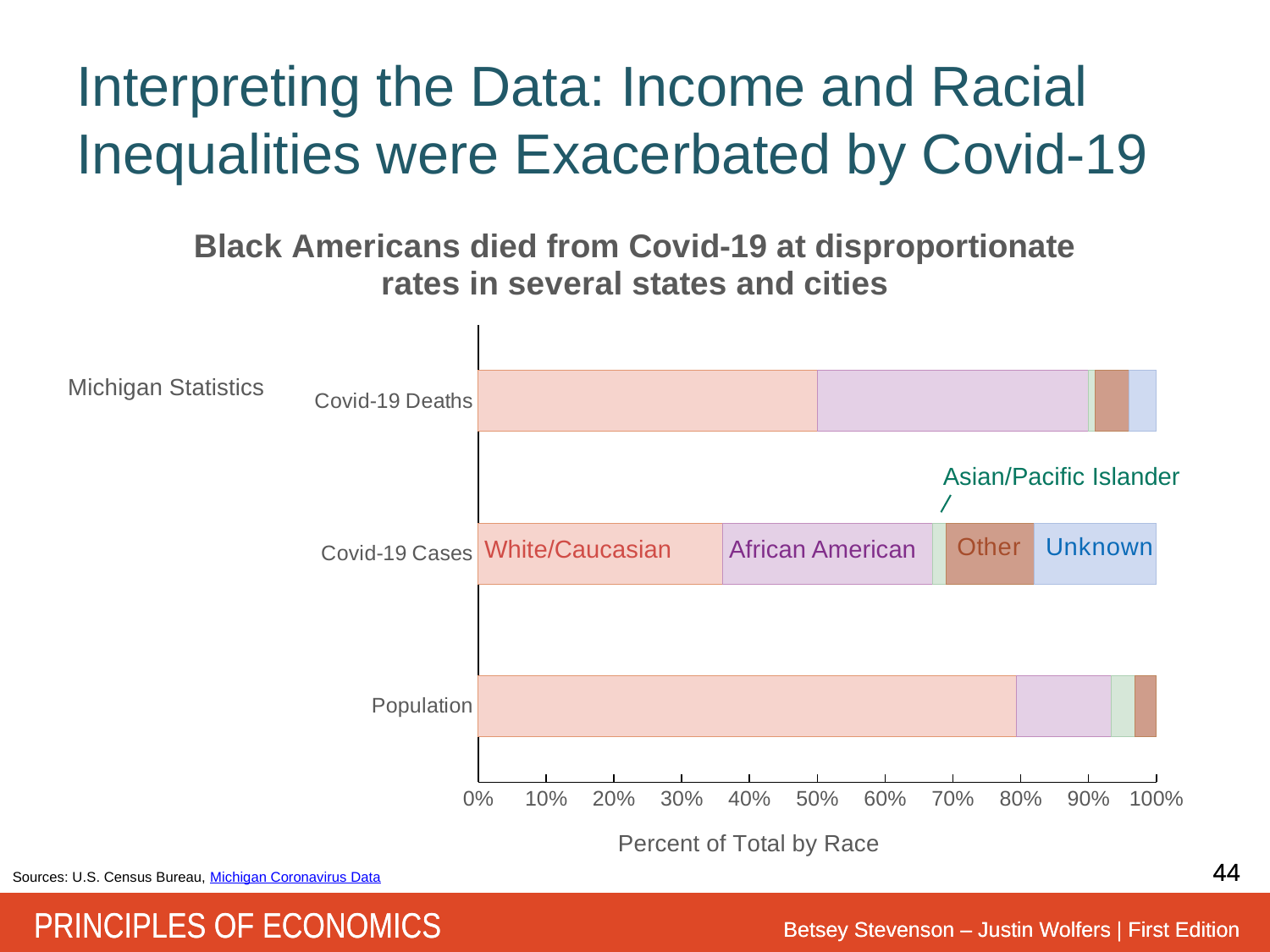
How many racial groups (series) are labelled in the chart? 5 Is the White/Caucasian share of the Covid-19 Cases bar greater or less than 40%? less Which bar has the smallest African American segment? Population Is the African American share of the Covid-19 Deaths bar greater or less than 30%? greater What is the title of the chart? Black Americans died from Covid-19 at disproportionate rates in several states and cities Is the African American share of the Population bar greater or less than 20%? less Which bar has the largest African American segment? Covid-19 Deaths What kind of chart is shown on the slide? Stacked bar chart Is the White/Caucasian share larger in the Population bar or in the Covid-19 Cases bar? Population What is the label of the x axis? Percent of Total by Race How many categories (bars) does the chart show? 3